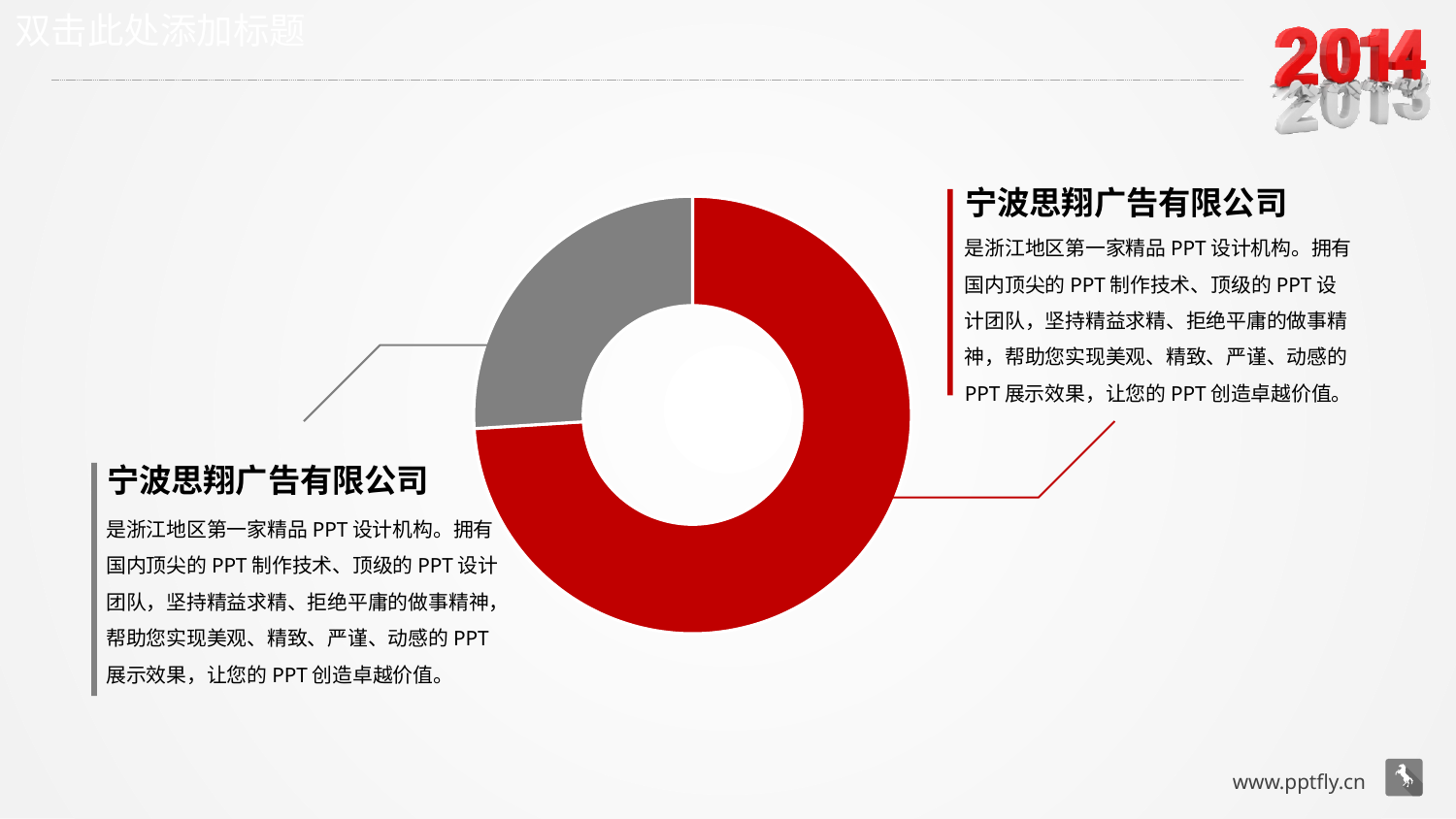
Which colour slice takes up the smallest share of the doughnut chart? grey How many slices does the doughnut chart have? 2 Which slice of the doughnut chart is larger, the red one or the grey one? the red one What kind of chart is shown on the slide? doughnut (pie) chart What two colours are used for the slices of the doughnut chart? red and grey Does the doughnut chart display a legend? No Which colour slice takes up the largest share of the doughnut chart? red